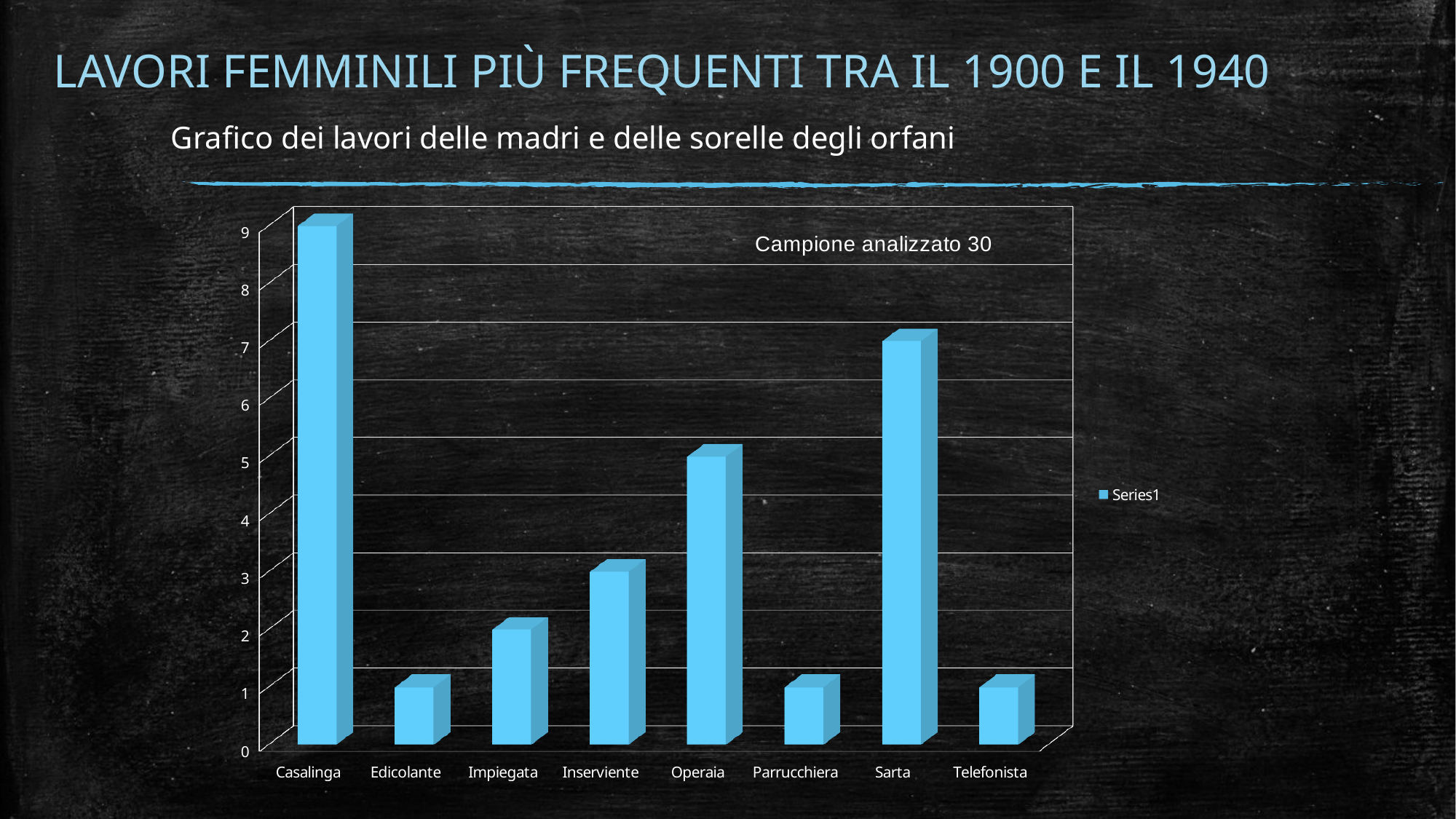
Which is larger, the value for Sarta or the value for Operaia? Sarta What kind of chart is shown on the slide? bar chart Which category has the highest bar in the chart? Casalinga What is the value for Sarta? 7 What is the value for Operaia? 5 How many series does the chart legend list? 1 What is the value for Inserviente? 3 What is the difference between the values for Casalinga and Sarta? 2 What is the value for Casalinga? 9 How many categories are shown on the x axis of the chart? 8 Is the value for Impiegata greater or less than 5? less What sample size is stated in the text inside the chart area? 30